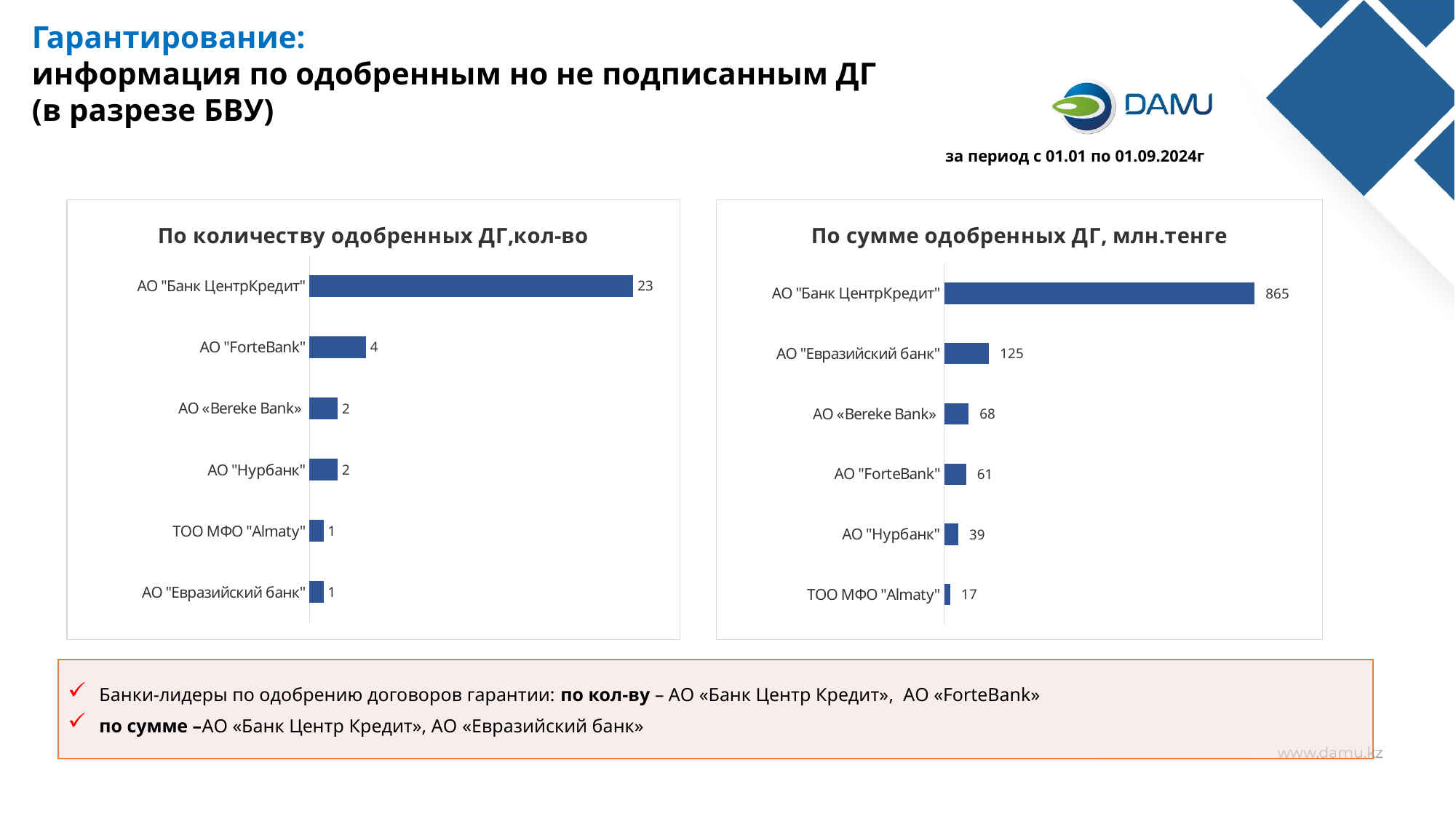
In the chart "По количеству одобренных ДГ,кол-во", what is the value for ТОО МФО "Almaty"? 1 In the chart "По количеству одобренных ДГ,кол-во", what is the difference between АО "Банк ЦентрКредит" and АО "ForteBank"? 19 In the chart "По количеству одобренных ДГ,кол-во", what is the value for АО "ForteBank"? 4 How many categories are shown in the chart "По количеству одобренных ДГ,кол-во"? 6 In the chart "По сумме одобренных ДГ, млн.тенге", which category has the lowest value? ТОО МФО "Almaty" What kind of chart is "По сумме одобренных ДГ, млн.тенге"? Bar chart In the chart "По сумме одобренных ДГ, млн.тенге", what is the value for АО "Евразийский банк"? 125 What is the title of the chart on the left side of the slide? По количеству одобренных ДГ,кол-во In the chart "По сумме одобренных ДГ, млн.тенге", which is larger: АО "ForteBank" or АО "Нурбанк"? АО "ForteBank" In the chart "По сумме одобренных ДГ, млн.тенге", what is the value for АО «Bereke Bank»? 68 In the chart "По количеству одобренных ДГ,кол-во", which category has the highest value? АО "Банк ЦентрКредит" In the chart "По сумме одобренных ДГ, млн.тенге", what is the difference between АО "Банк ЦентрКредит" and АО "Евразийский банк"? 740